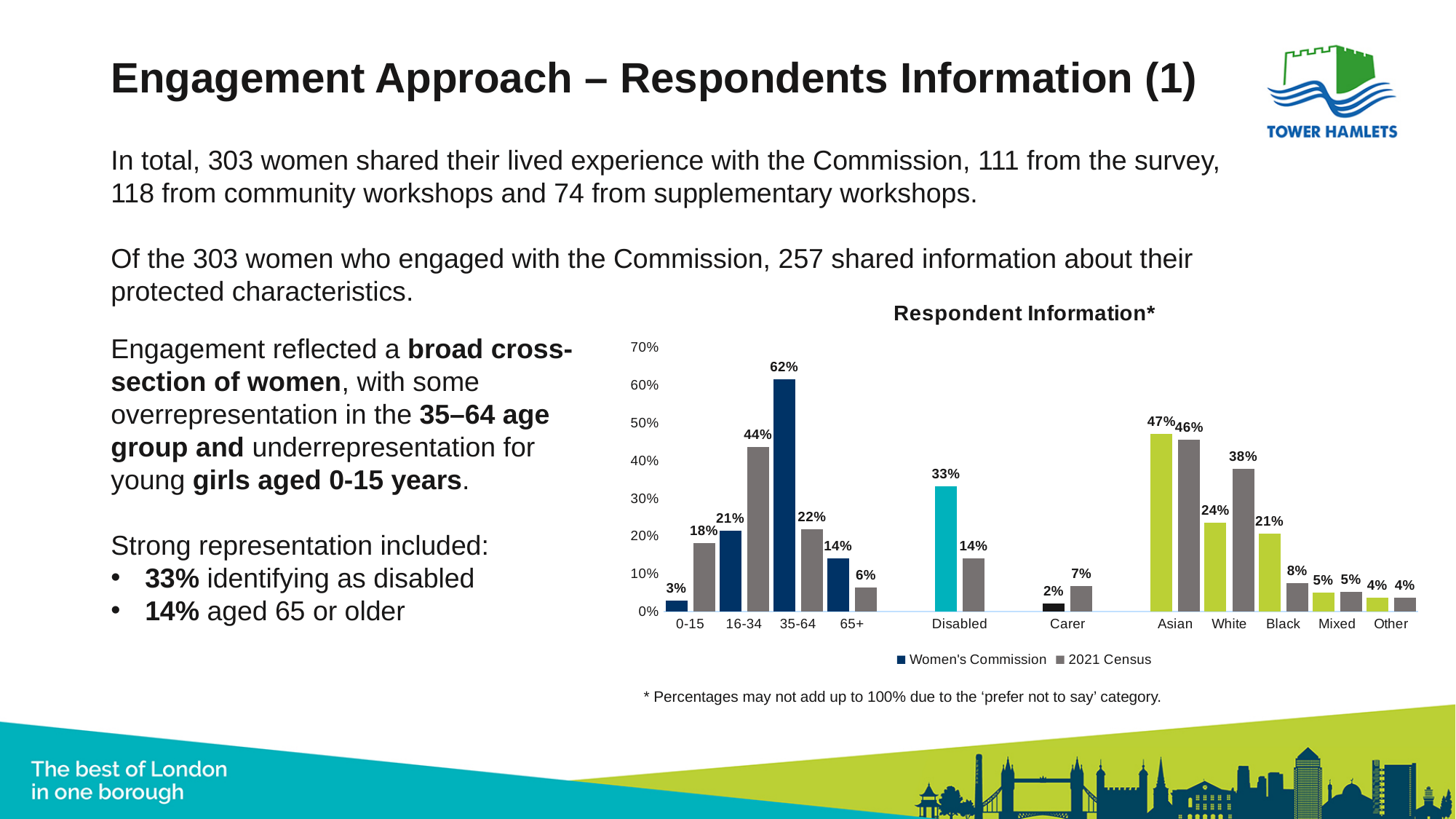
What is the title of the chart? Respondent Information* What is the Women's Commission value for Disabled? 33% What is the 2021 Census value for White? 38% What kind of chart is shown on the slide? Bar chart Which is larger for Black: the Women's Commission value or the 2021 Census value? Women's Commission How many categories are shown on the x axis? 11 What is the difference between the Women's Commission and 2021 Census values for the 0-15 age group? 15% Which category has the highest Women's Commission value? 35-64 How many series does the legend list? 2 Which category has the lowest Women's Commission value? Carer What is the 2021 Census value for the 16-34 age group? 44% What is the Women's Commission value for the 35-64 age group? 62%